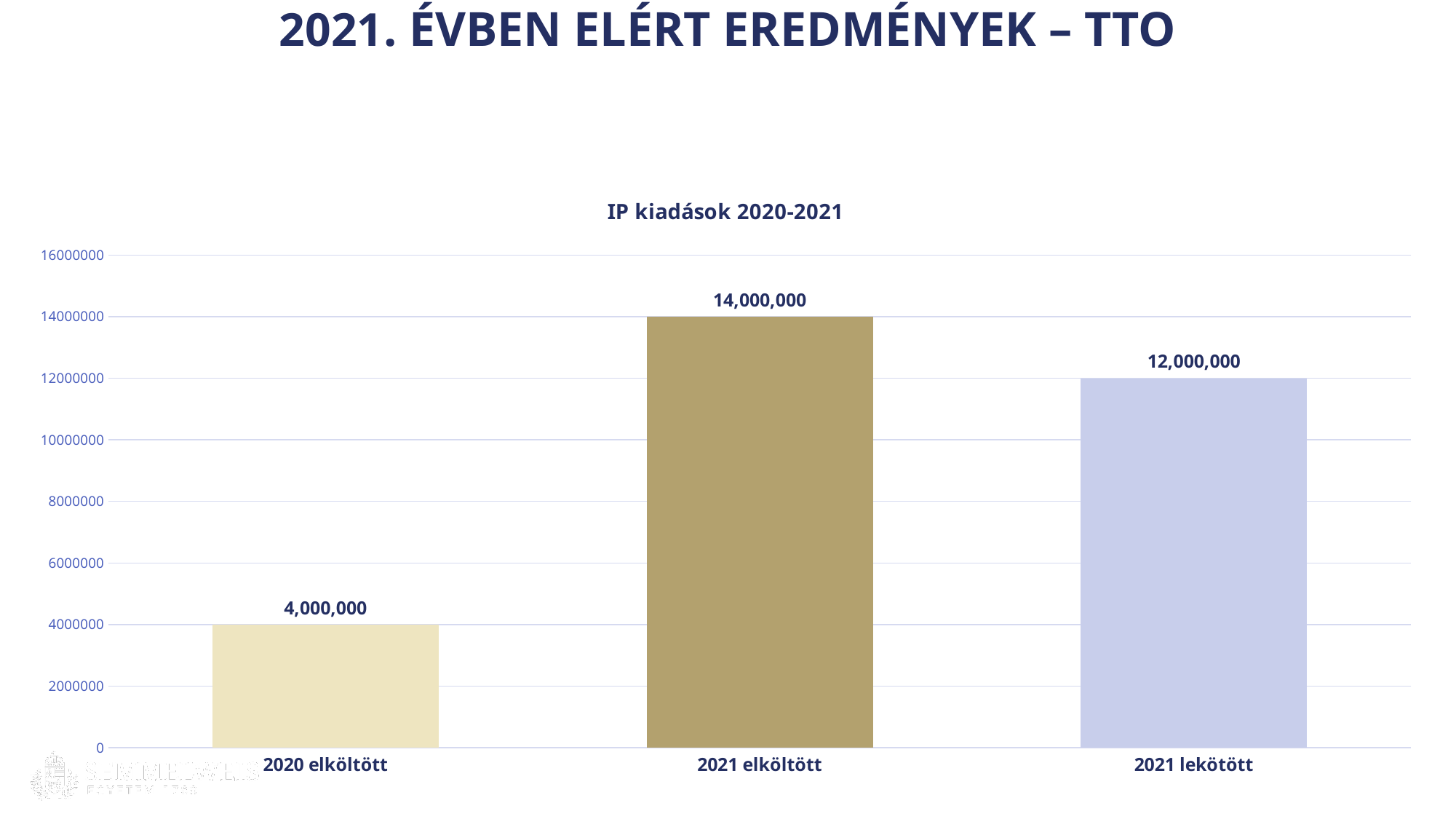
How many categories are shown in the chart? 3 What is the difference between the values for 2021 elköltött and 2021 lekötött? 2,000,000 Which category has the highest value? 2021 elköltött Is the value for 2021 lekötött greater or less than 10000000? greater Which is larger, the value for 2021 lekötött or the value for 2020 elköltött? 2021 lekötött What is the difference between the values for 2021 elköltött and 2020 elköltött? 10,000,000 What is the value for 2021 elköltött? 14,000,000 What kind of chart is shown on the slide? bar chart What is the title of the chart? IP kiadások 2020-2021 Which category has the lowest value? 2020 elköltött What is the value for 2021 lekötött? 12,000,000 What is the value for 2020 elköltött? 4,000,000